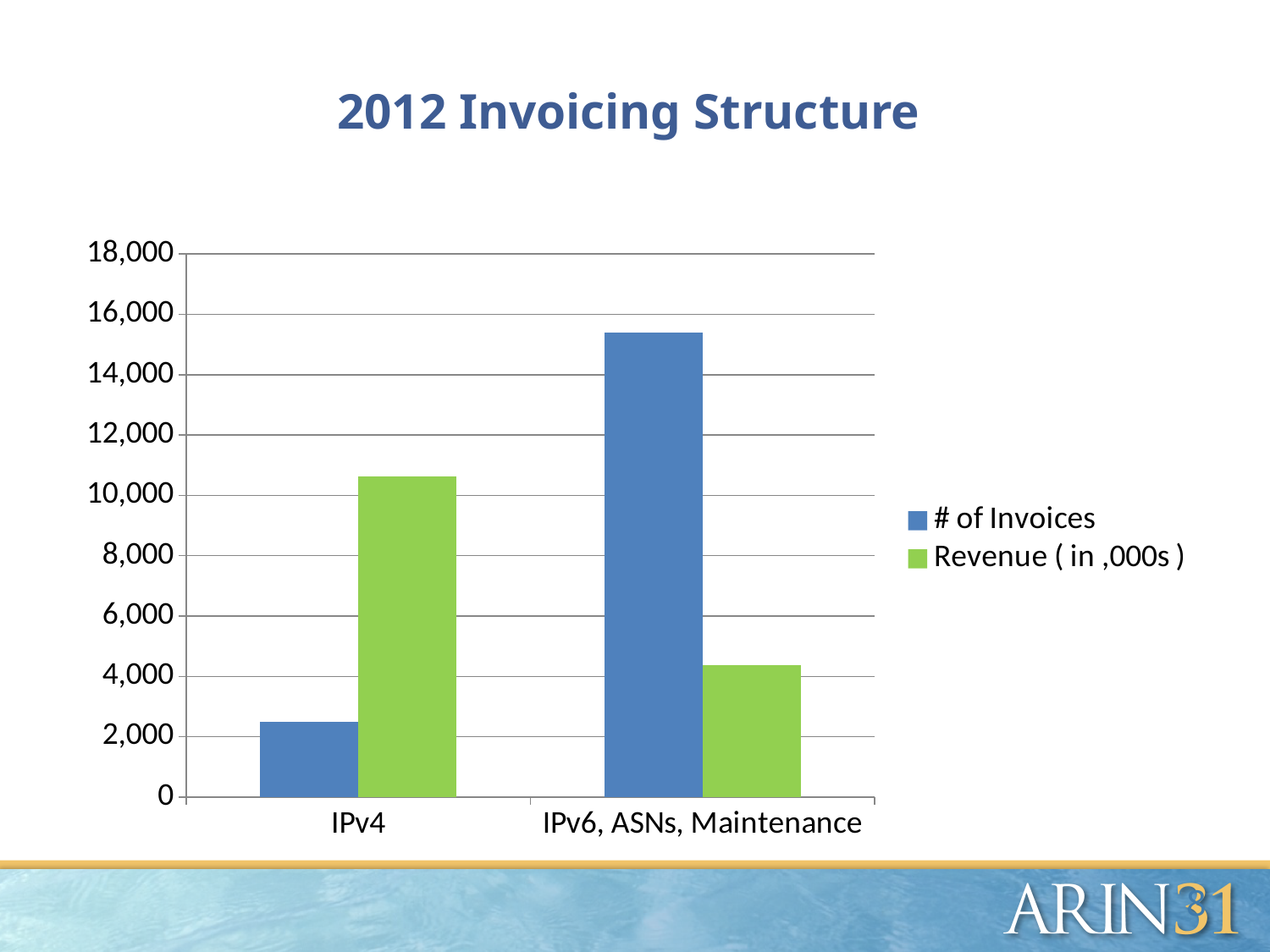
Is the value for # of Invoices for IPv4 greater or less than 4,000? less How many categories are shown on the x axis? 2 Is the value for Revenue ( in ,000s ) for IPv6, ASNs, Maintenance greater or less than 6,000? less What kind of chart is shown on the slide? bar chart Which series is shown in green? Revenue ( in ,000s ) How many series does the legend list? 2 What is the title of the chart? 2012 Invoicing Structure For IPv4, which is larger: # of Invoices or Revenue ( in ,000s )? Revenue ( in ,000s ) Is the value for Revenue ( in ,000s ) for IPv4 greater or less than 8,000? greater Which category has the higher # of Invoices? IPv6, ASNs, Maintenance Which category has the lower Revenue ( in ,000s )? IPv6, ASNs, Maintenance